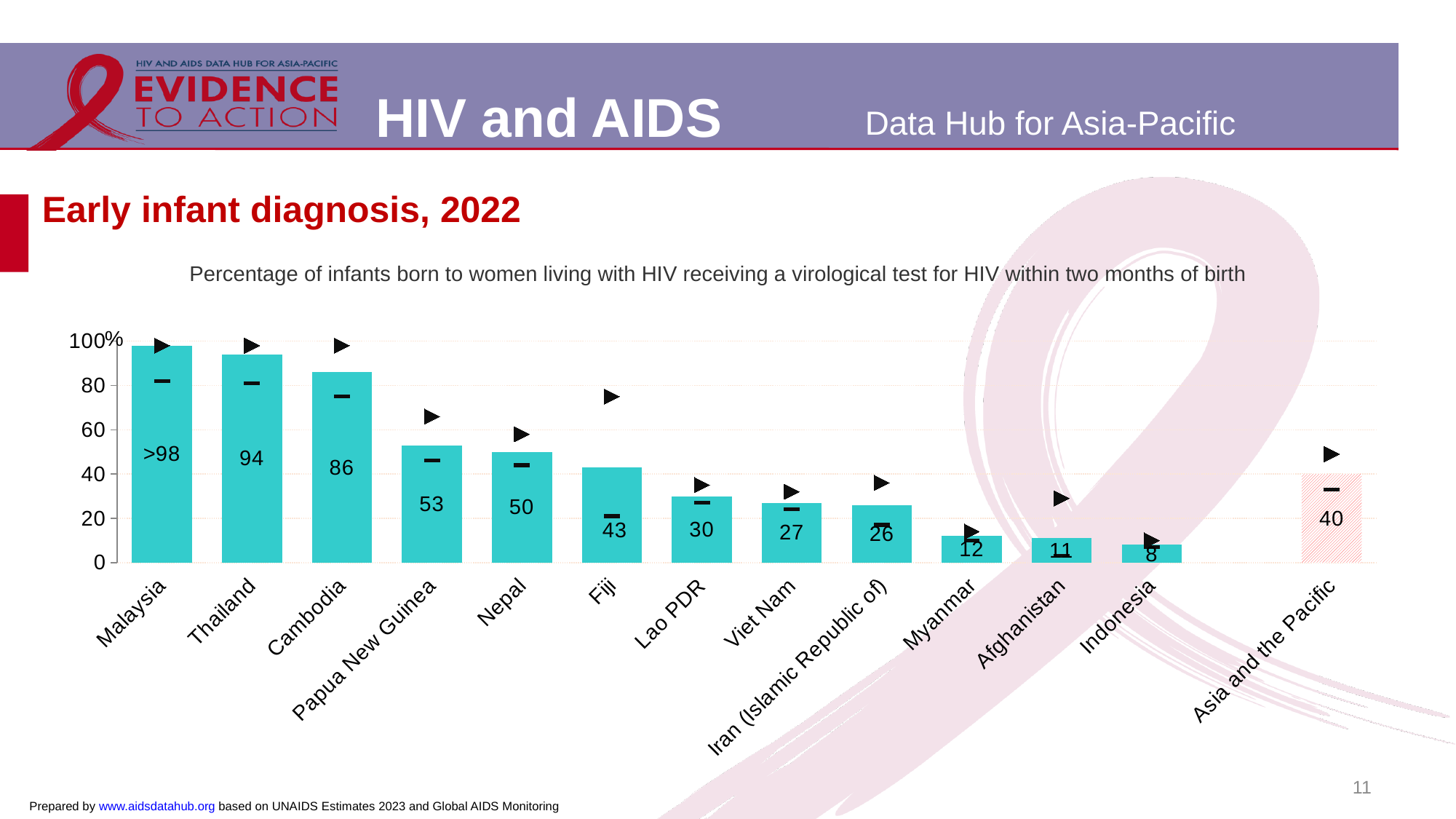
Which country has the highest value? Malaysia What is the value for Thailand? 94 How many categories are shown on the x axis? 13 Which country has the lowest value? Indonesia What kind of chart is this? Bar chart What is the value for Papua New Guinea? 53 What is the difference between the values for Nepal and Fiji? 7 Which is larger, the value for Lao PDR or the value for Myanmar? Lao PDR What is the title of the slide? Early infant diagnosis, 2022 What is the value for Asia and the Pacific? 40 What is the difference between the values for Thailand and Cambodia? 8 What is the value for Viet Nam? 27